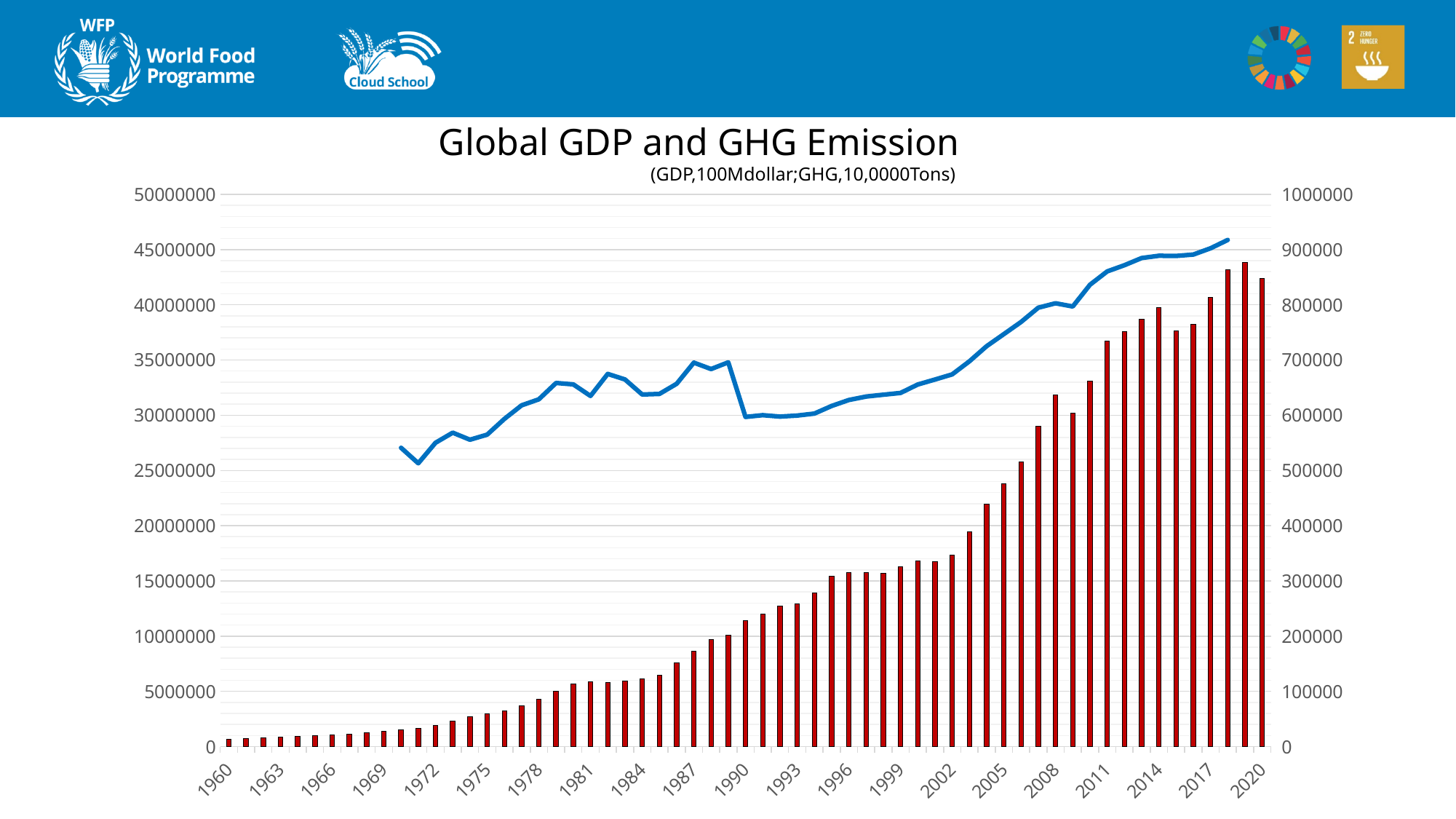
What is the first year and the last year labelled on the x axis? 1960 and 2020 In which year does the blue line reach its lowest point? 1971 What kind of chart is shown on the slide? A combination bar and line chart In which year does the blue line reach its highest point? 2018 What is the title of the chart? Global GDP and GHG Emission Do the red bars generally rise or fall from 1960 to 2020? Rise What units are given in the chart subtitle? (GDP,100Mdollar;GHG,10,0000Tons) Which year has the shortest red bar? 1960 Which year has the tallest red bar? 2019 How many red bars are plotted on the chart (one per year from 1960 to 2020)? 61 Is the blue line value for 1989 higher or lower than for 1990? Higher Is the red bar for 2008 taller or shorter than the red bar for 2009? Taller